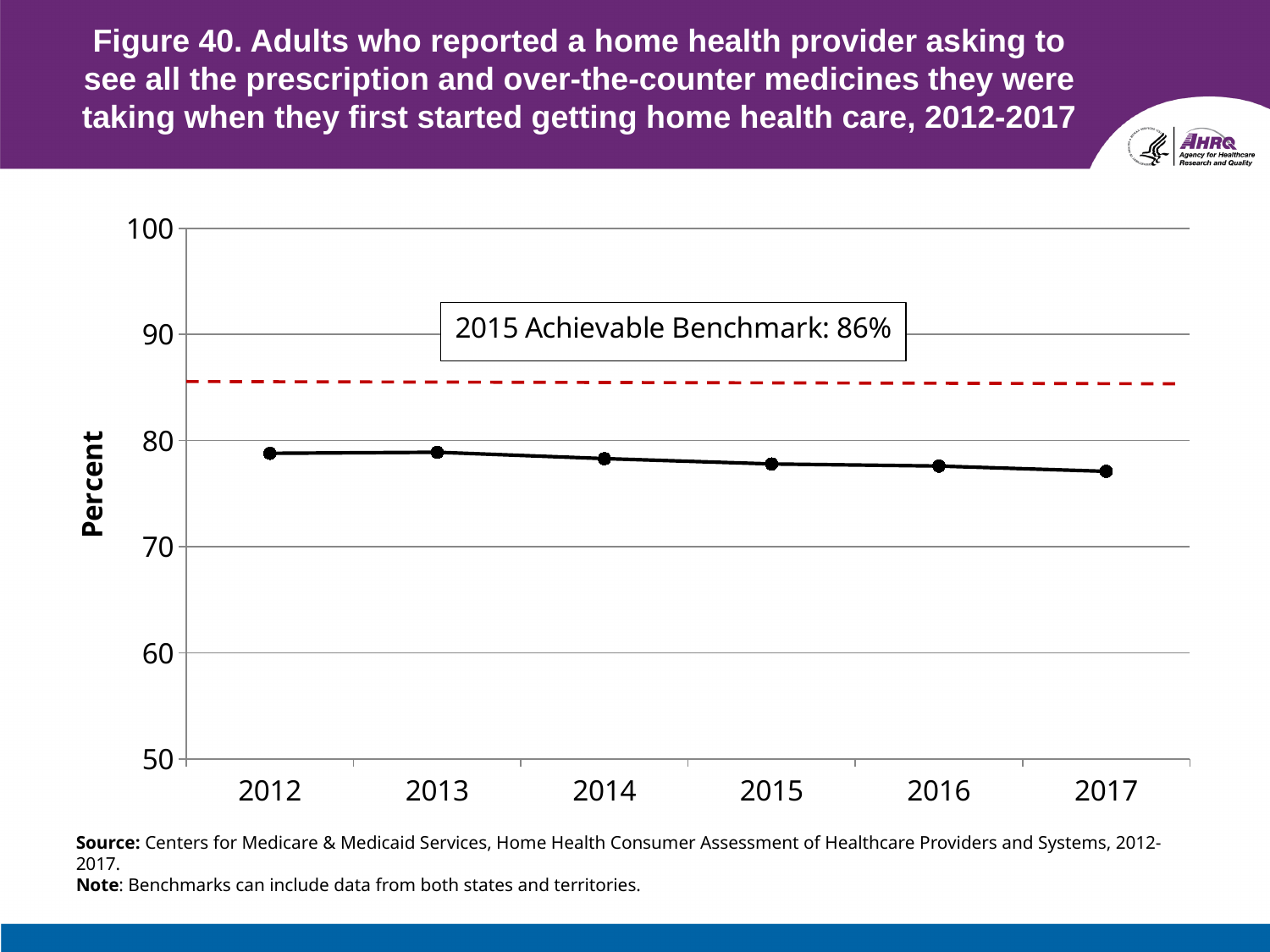
What is the 2015 Achievable Benchmark shown on the chart? 86% How many years (data points) are plotted on the chart? 6 What is the first year shown on the horizontal axis? 2012 What is the label on the vertical axis? Percent What kind of chart is shown on the slide? line chart Is the plotted line above or below the 2015 Achievable Benchmark line in every year? below Is the value for 2012 greater or less than 80? less Do the plotted values rise or fall from 2012 to 2017? fall Is the value for 2015 greater or less than 80? less Which is larger, the value for 2012 or the value for 2017? 2012 Is the value for 2017 greater or less than 70? greater